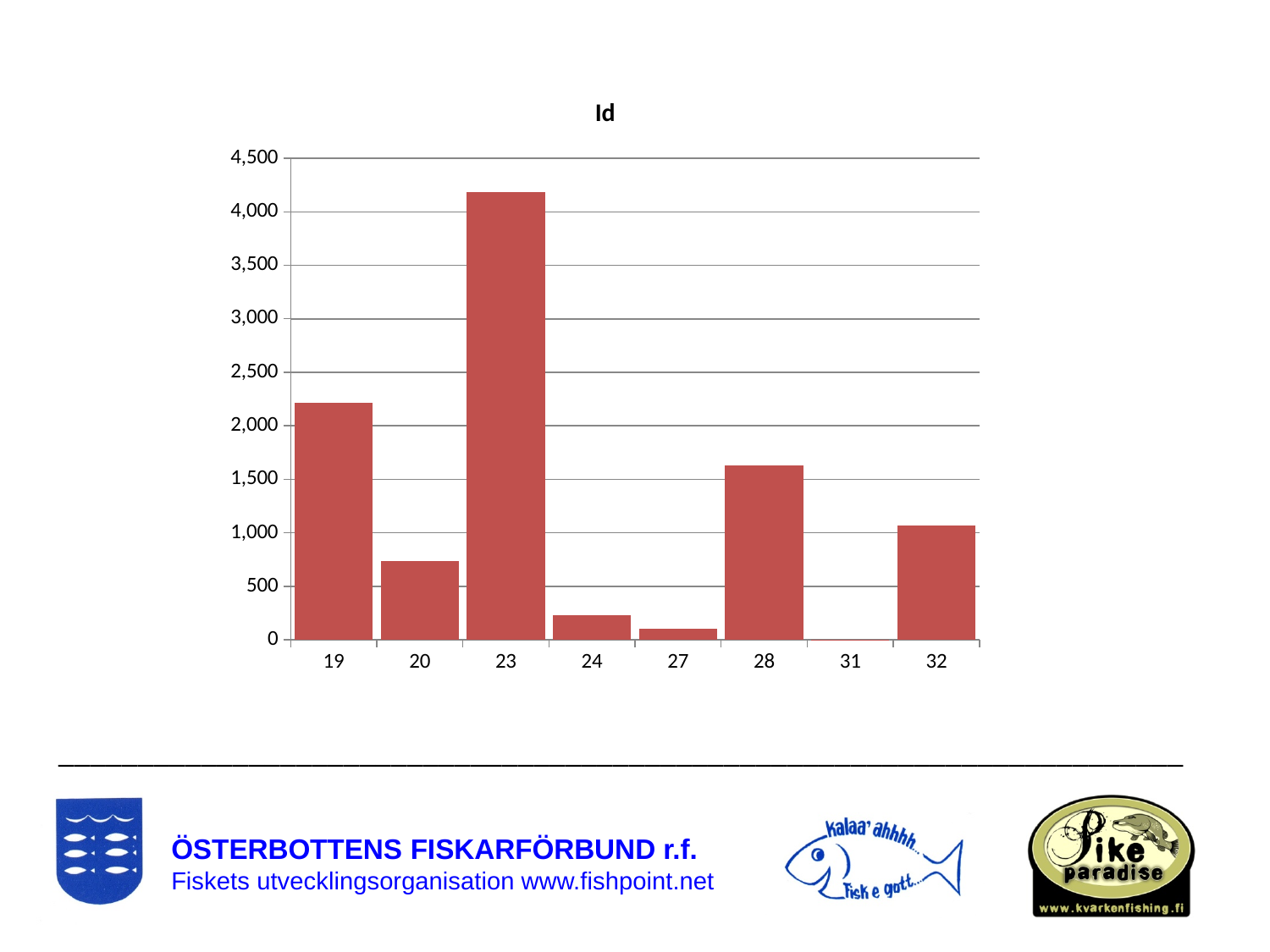
Which has the larger value, category 19 or category 28? 19 Which has the larger value, category 24 or category 27? 24 Is the value for category 28 greater or less than 1,500? greater Which category has the lowest value in the chart? 31 Is the value for category 23 greater or less than 4,000? greater Is the value for category 20 greater or less than 1,000? less What kind of chart is shown on the slide? bar chart What is the title of the chart? Id How many categories are shown on the x axis of the chart? 8 Which category has the highest value in the chart? 23